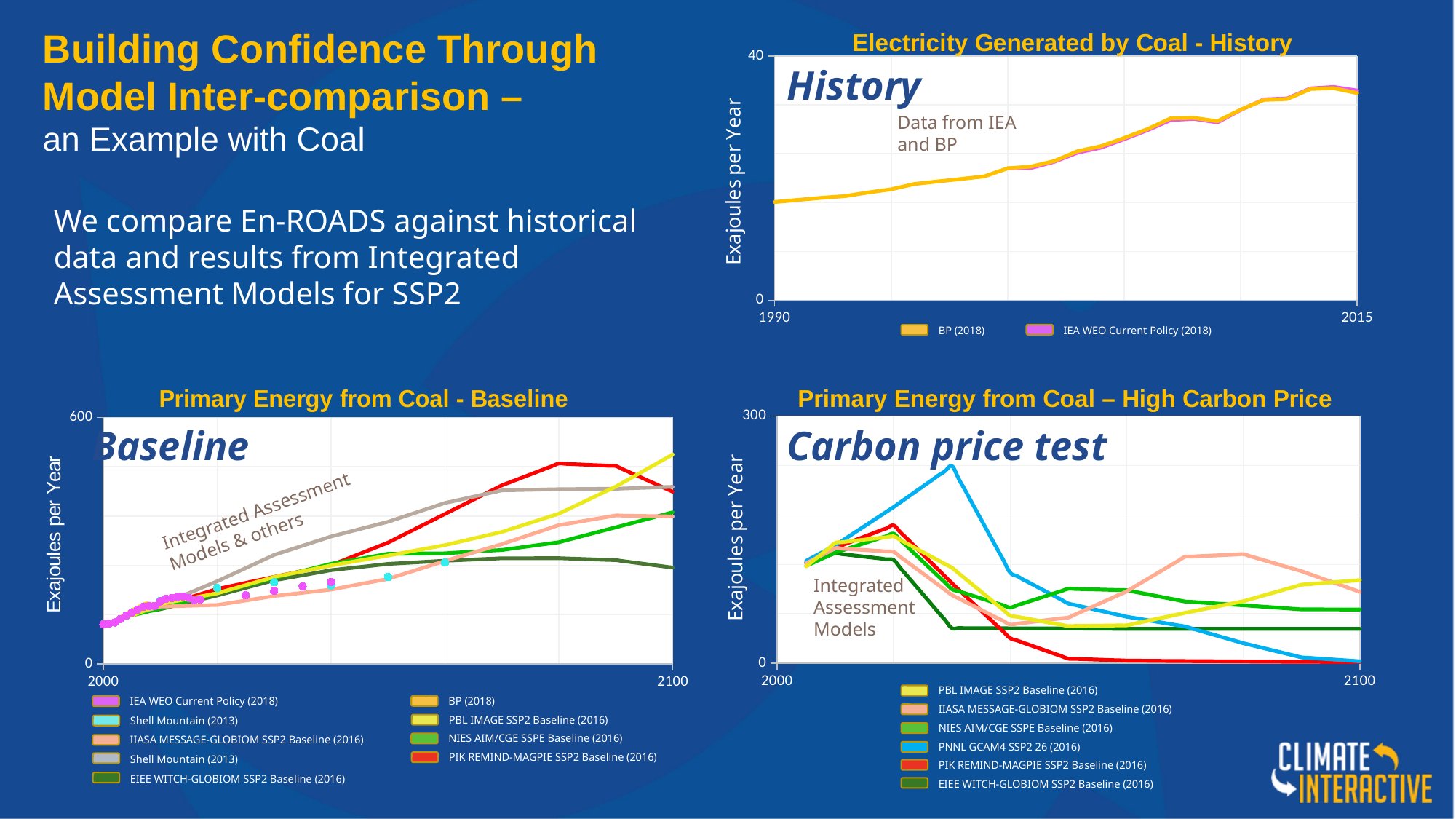
On the 'Primary Energy from Coal – High Carbon Price' chart, which series reaches the highest peak value? PNNL GCAM4 SSP2 26 (2016) On the 'Primary Energy from Coal – High Carbon Price' chart, how many series does the legend list? 6 On the 'Electricity Generated by Coal - History' chart, what kind of chart is shown? Line chart On the 'Primary Energy from Coal - Baseline' chart, is the value for PBL IMAGE SSP2 Baseline (2016) at 2100 greater or less than 300? greater On the 'Primary Energy from Coal - Baseline' chart, how many series does the legend list? 9 On the 'Primary Energy from Coal - Baseline' chart, at 2100, which is larger: PBL IMAGE SSP2 Baseline (2016) or EIEE WITCH-GLOBIOM SSP2 Baseline (2016)? PBL IMAGE SSP2 Baseline (2016) On the 'Electricity Generated by Coal - History' chart, what is the highest value shown on the y-axis? 40 On the 'Primary Energy from Coal - Baseline' chart, which series has the highest value at 2100? PBL IMAGE SSP2 Baseline (2016) On the 'Primary Energy from Coal – High Carbon Price' chart, is the value for PIK REMIND-MAGPIE SSP2 Baseline (2016) at 2100 greater or less than 100? less On the 'Electricity Generated by Coal - History' chart, do the values rise or fall from 1990 to 2015? Rise On the 'Electricity Generated by Coal - History' chart, how many series does the legend list? 2 On the 'Electricity Generated by Coal - History' chart, what is the y-axis label? Exajoules per Year